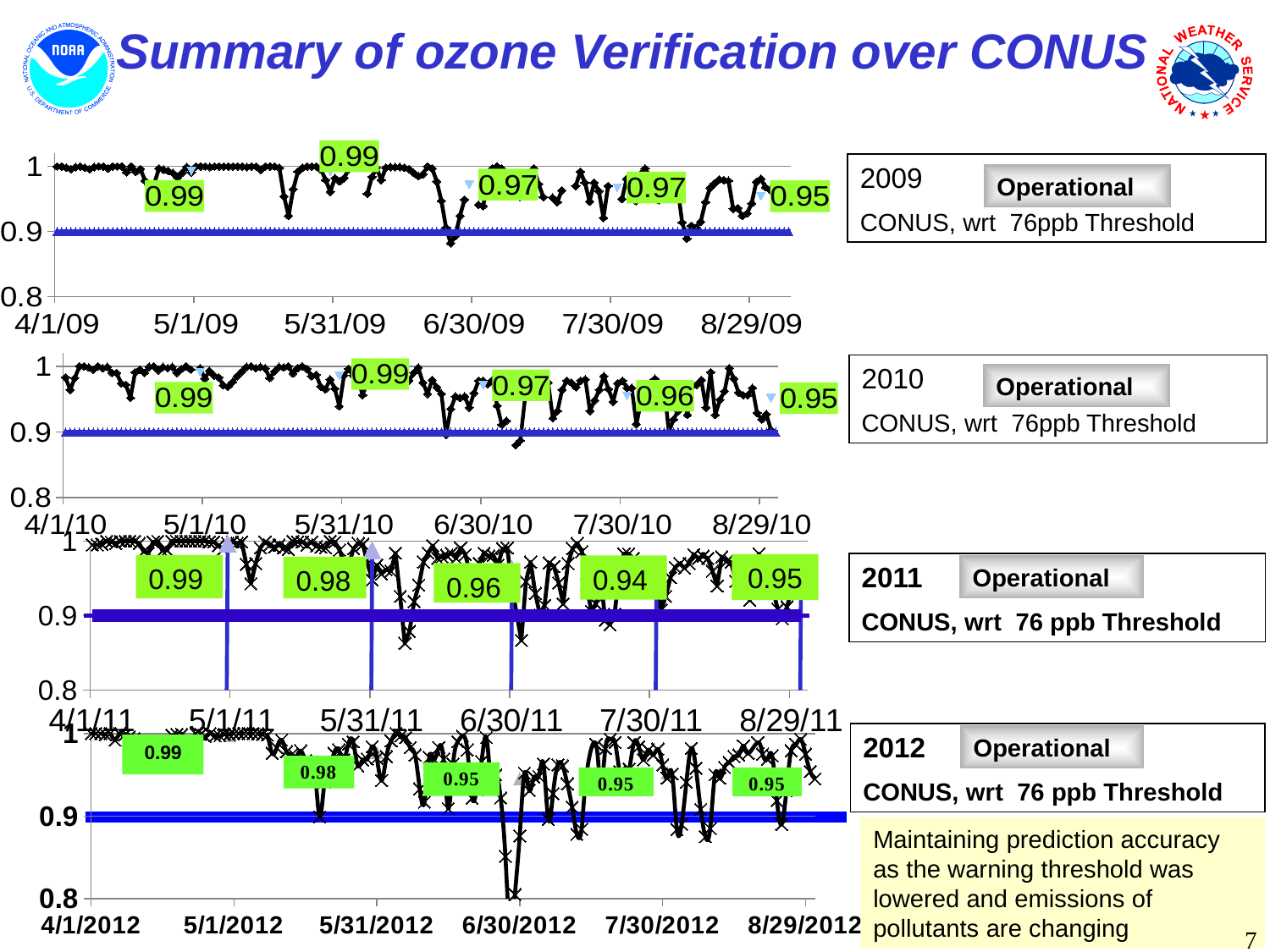
How many green value labels are shown on the 2009 chart? 5 On the 2009 chart, is the value at 4/1/09 greater or less than 0.9? greater What is the last date label on the x axis of the 2012 chart? 8/29/2012 On the 2012 chart, is the value at the deepest dip near 6/30/2012 greater or less than 0.9? less On the 2012 chart, what is the leftmost green labelled value? 0.99 On the 2011 chart, what is the lowest green labelled value? 0.94 On the 2010 chart, what is the rightmost green labelled value? 0.95 According to the text box beside the 2011 chart, what ozone threshold is the verification computed with respect to? 76 ppb On the 2009 chart, do the green labelled values rise or fall from left to right along the x axis? fall On the 2011 chart, what is the difference between the first green labelled value (0.99) and the lowest green labelled value (0.94)? 0.05 What kind of chart is the 2009 chart at the top of the slide? line chart On the 2010 chart, which is larger: the third green labelled value or the fourth green labelled value? the third (0.97)